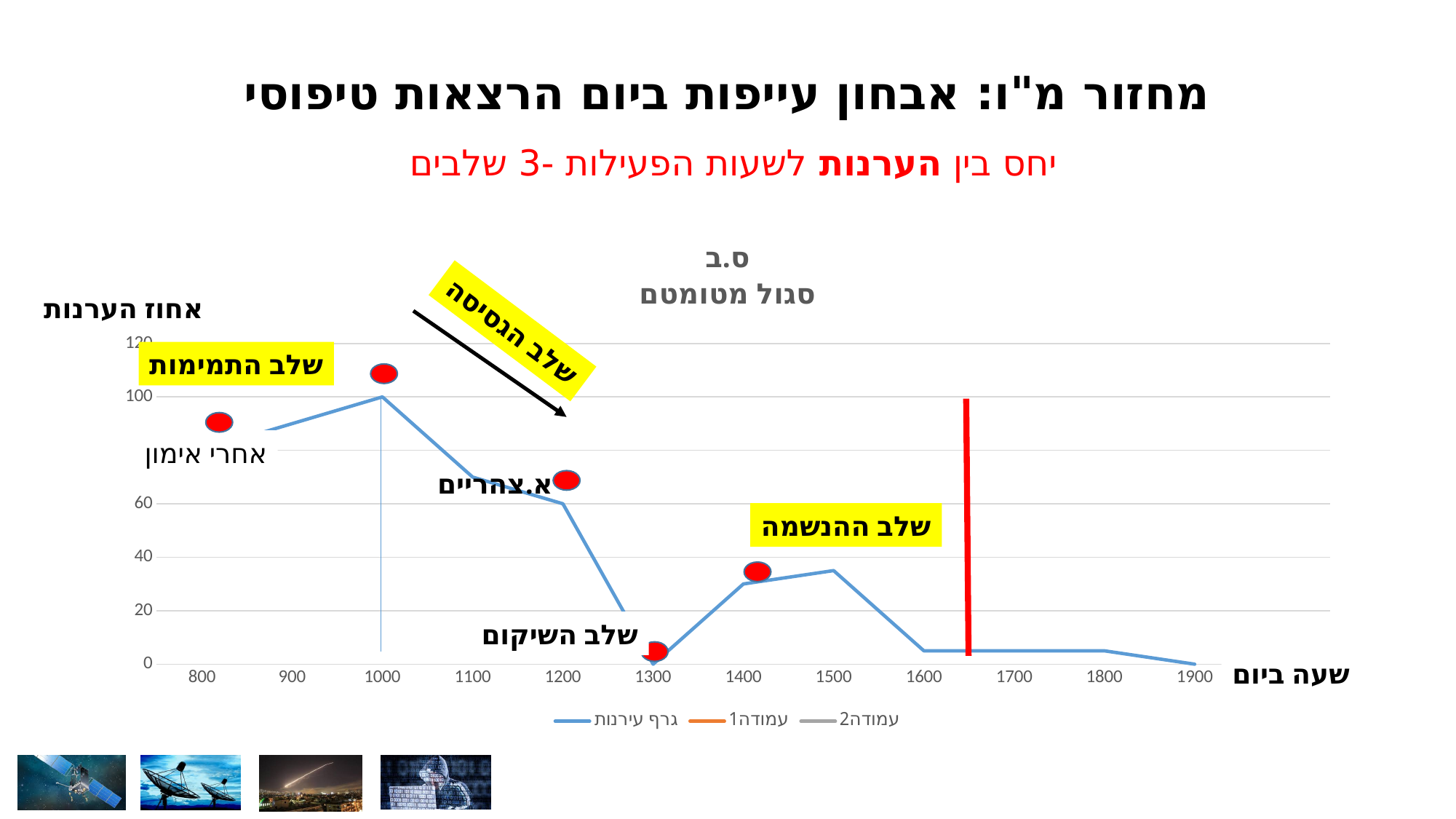
Which is larger, the alertness value at 1000 or at 1500? 1000 What is the difference between the alertness values at 1000 and 1200? 40 What kind of chart is shown on the slide? line chart What is the title of the vertical axis? אחוז הערנות Is the value of the alertness line at 1400 greater or less than 20? greater What is the value of the alertness line at 1000? 100 How many series does the legend list? 3 Is the value of the alertness line at 1600 greater or less than 20? less At which hour does the alertness line reach its highest value? 1000 What is the value of the alertness line at 1200? 60 What is the value of the alertness line at 1900? 0 Does the alertness line rise or fall between 1000 and 1300? fall